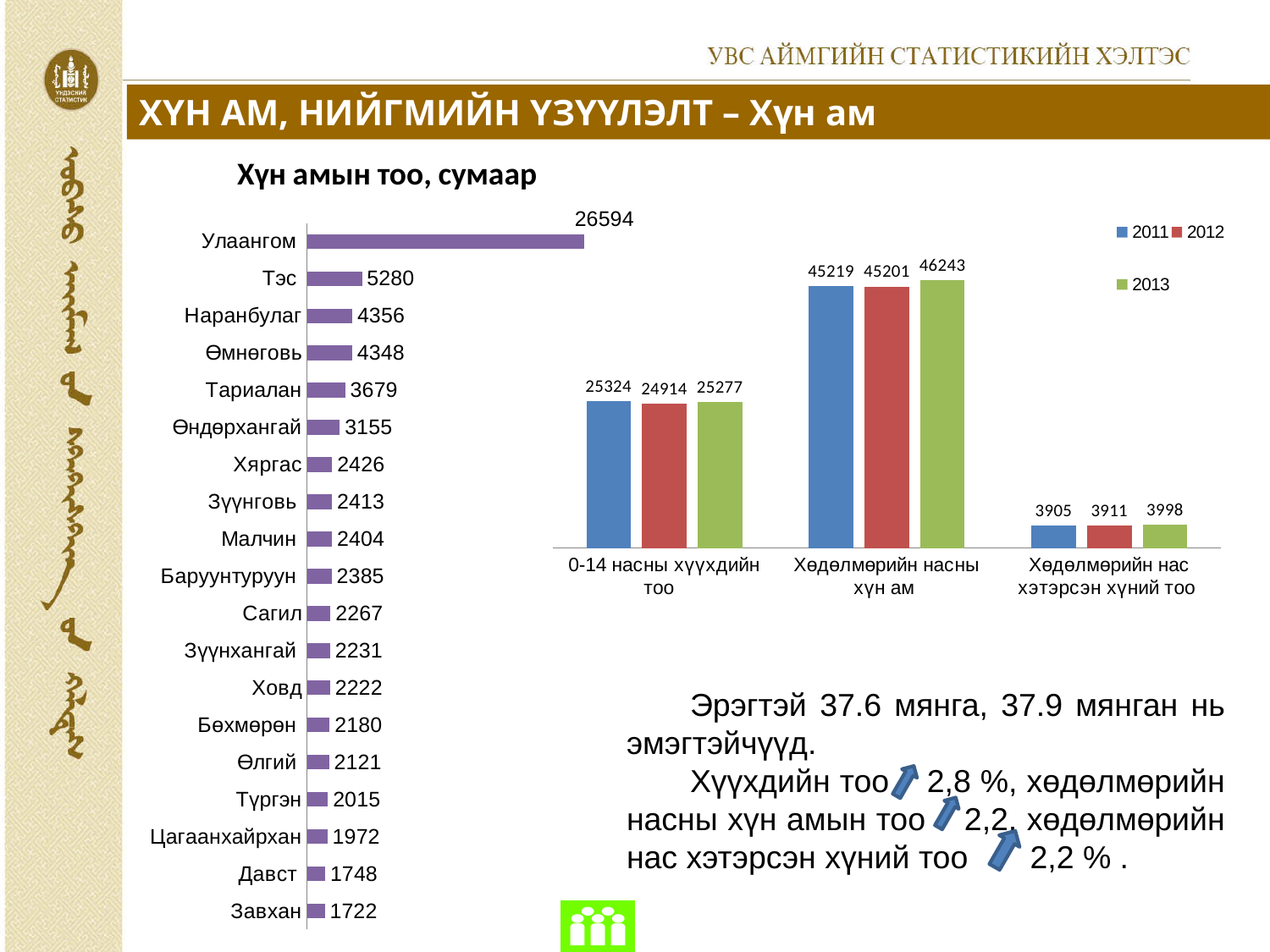
In the chart on the right, which category has the highest values across all years? Хөдөлмөрийн насны хүн ам In the chart titled "Хүн амын тоо, сумаар", which sum has the highest population? Улаангом In the chart on the right, how many series does the legend list? 3 In the chart on the right, what is the difference between the 2013 and 2011 values for Хөдөлмөрийн нас хэтэрсэн хүний тоо? 93 In the chart titled "Хүн амын тоо, сумаар", how many sums are listed? 19 In the chart on the right, what is the value for Хөдөлмөрийн насны хүн ам in 2013? 46243 In the chart titled "Хүн амын тоо, сумаар", what is the value for Улаангом? 26594 What kind of chart is the chart titled "Хүн амын тоо, сумаар"? bar chart In the chart titled "Хүн амын тоо, сумаар", which is larger, the value for Тариалан or the value for Өндөрхангай? Тариалан In the chart titled "Хүн амын тоо, сумаар", what is the difference between the values for Тэс and Наранбулаг? 924 In the chart on the right, what is the value for 0-14 насны хүүхдийн тоо in 2012? 24914 In the chart titled "Хүн амын тоо, сумаар", which sum has the lowest population? Завхан